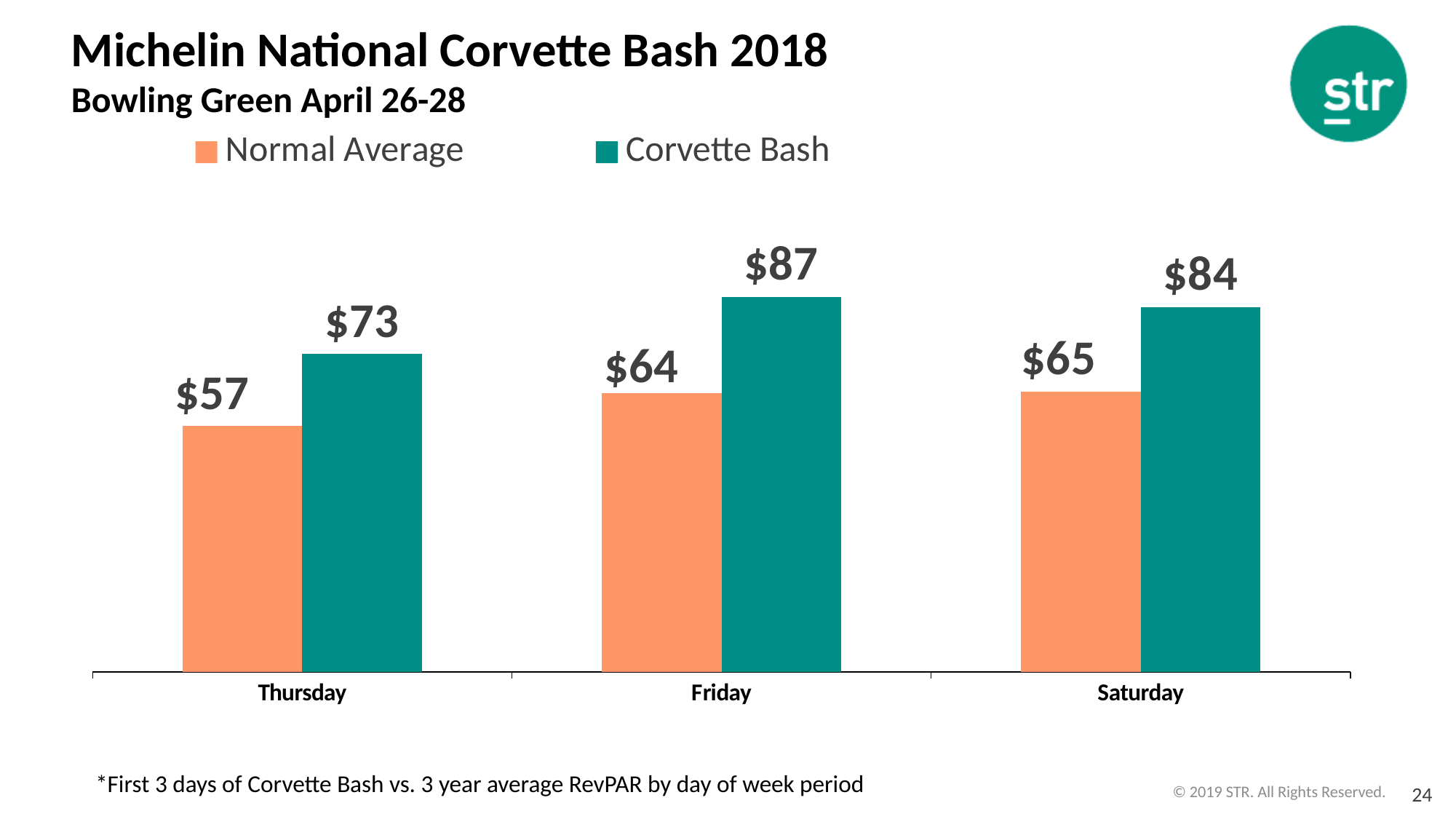
What is the difference between the Corvette Bash values for Friday and Saturday? $3 Which is larger on Saturday, the Normal Average or the Corvette Bash value? Corvette Bash What kind of chart is shown on the slide? Bar chart What is the Normal Average value for Thursday? $57 What is the difference between the Corvette Bash and Normal Average values for Thursday? $16 Which colour represents the Corvette Bash series in the legend? Teal (green) How many days are shown on the x axis? 3 What is the Corvette Bash value for Friday? $87 How many series does the legend list? 2 What is the Normal Average value for Saturday? $65 Which day has the lowest Normal Average value? Thursday Which day has the highest Corvette Bash value? Friday